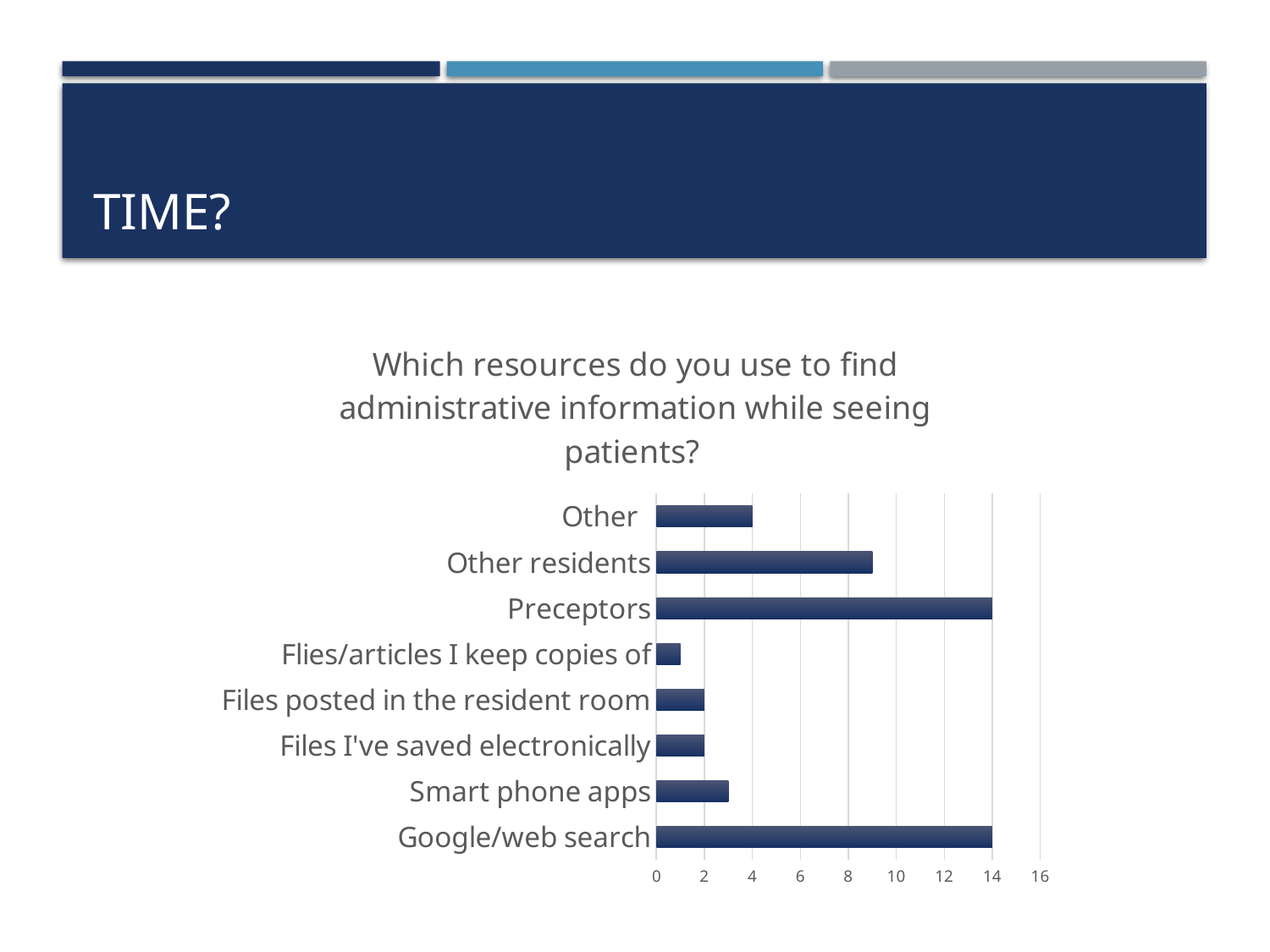
What is the value for Google/web search? 14 Which category has the lowest value? Flies/articles I keep copies of Which is larger, the value for Other residents or the value for Other? Other residents What is the value for Files posted in the resident room? 2 How many categories are shown in the chart? 8 What is the value for Preceptors? 14 What is the value for Other? 4 What type of chart is shown on the slide? bar chart What is the title of the chart? Which resources do you use to find administrative information while seeing patients? Is the value for Other residents greater or less than 8? greater Is the value for Smart phone apps greater or less than 4? less What is the difference between the value for Preceptors and the value for Other? 10